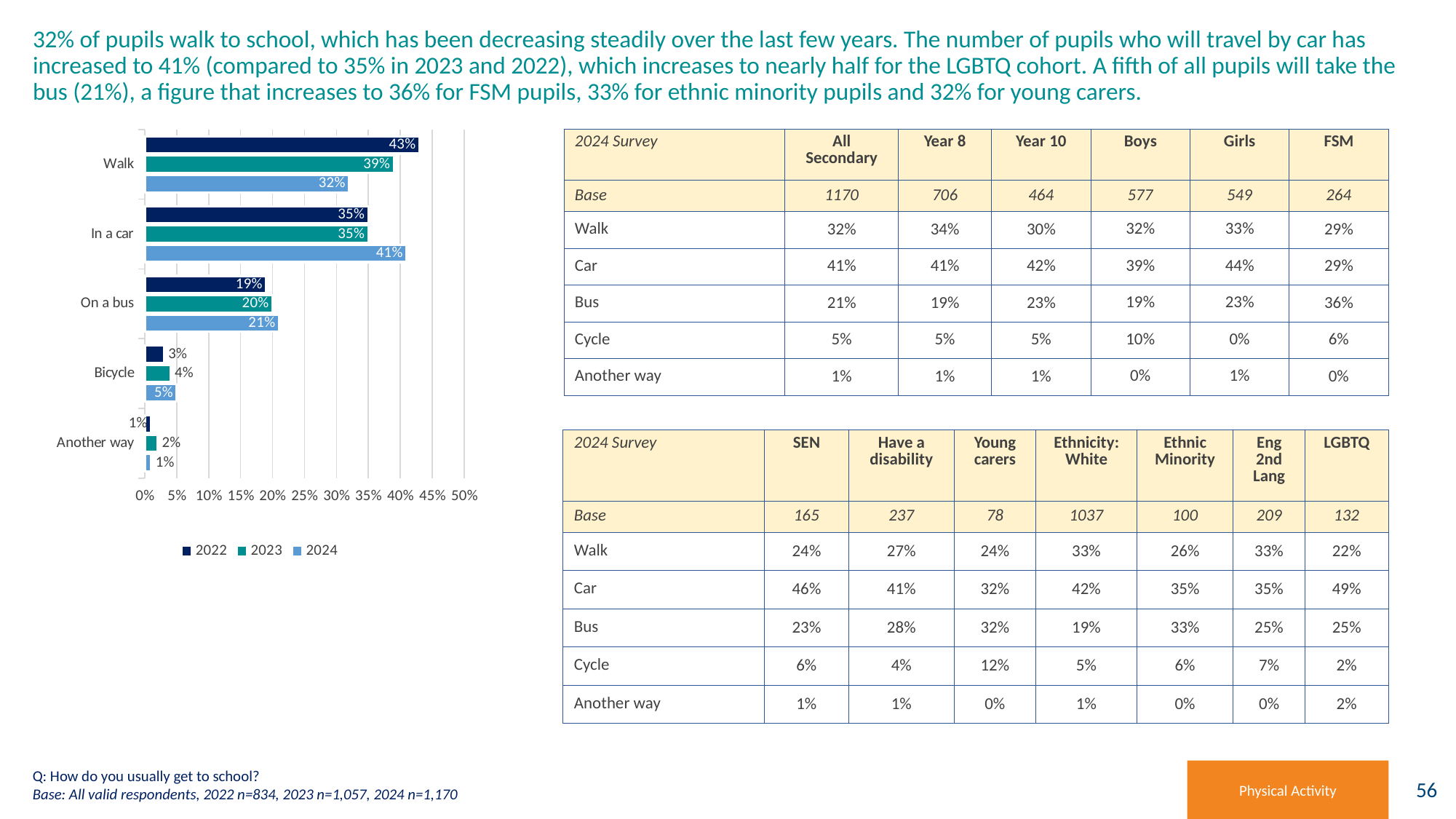
What type of chart is shown on the slide? bar chart By how many percentage points did the 'Walk' value fall from 2022 to 2024 in the chart? 11 In the chart, is the 2024 value for 'In a car' larger or smaller than the 2024 value for 'Walk'? larger Which category has the lowest value for the 2023 series in the chart? Another way Which category has the highest value for the 2024 series in the chart? In a car How many categories are shown on the chart's vertical axis? 5 What is the 2022 value for 'In a car' in the chart? 35% How many series does the chart's legend list? 3 What is the 2023 value for 'On a bus' in the chart? 20% Which years are listed in the chart's legend? 2022, 2023, 2024 What percentage of pupils walked to school in 2024 according to the chart? 32% Does the 'Walk' value rise or fall from 2022 to 2024 in the chart? fall